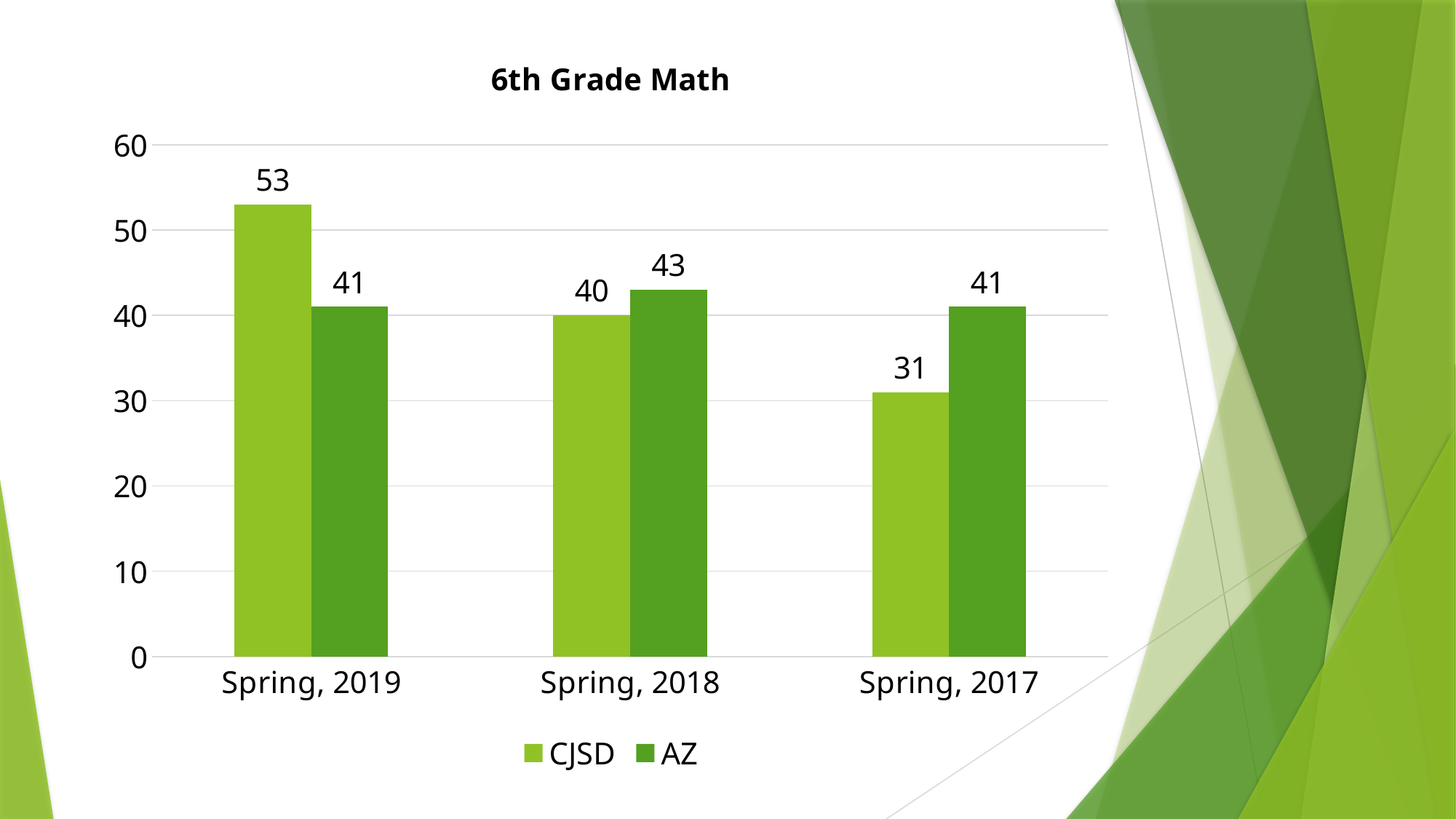
What is the title of the chart? 6th Grade Math What is the CJSD value for Spring, 2019? 53 What is the CJSD value for Spring, 2017? 31 What kind of chart is shown? bar chart Which category has the lowest CJSD value? Spring, 2017 How many categories are shown on the x axis? 3 How many series does the legend list? 2 What is the difference between the CJSD and AZ values for Spring, 2019? 12 For Spring, 2018, which is larger, the CJSD value or the AZ value? AZ What is the AZ value for Spring, 2018? 43 What is the difference between the CJSD values for Spring, 2019 and Spring, 2017? 22 Which category has the highest CJSD value? Spring, 2019